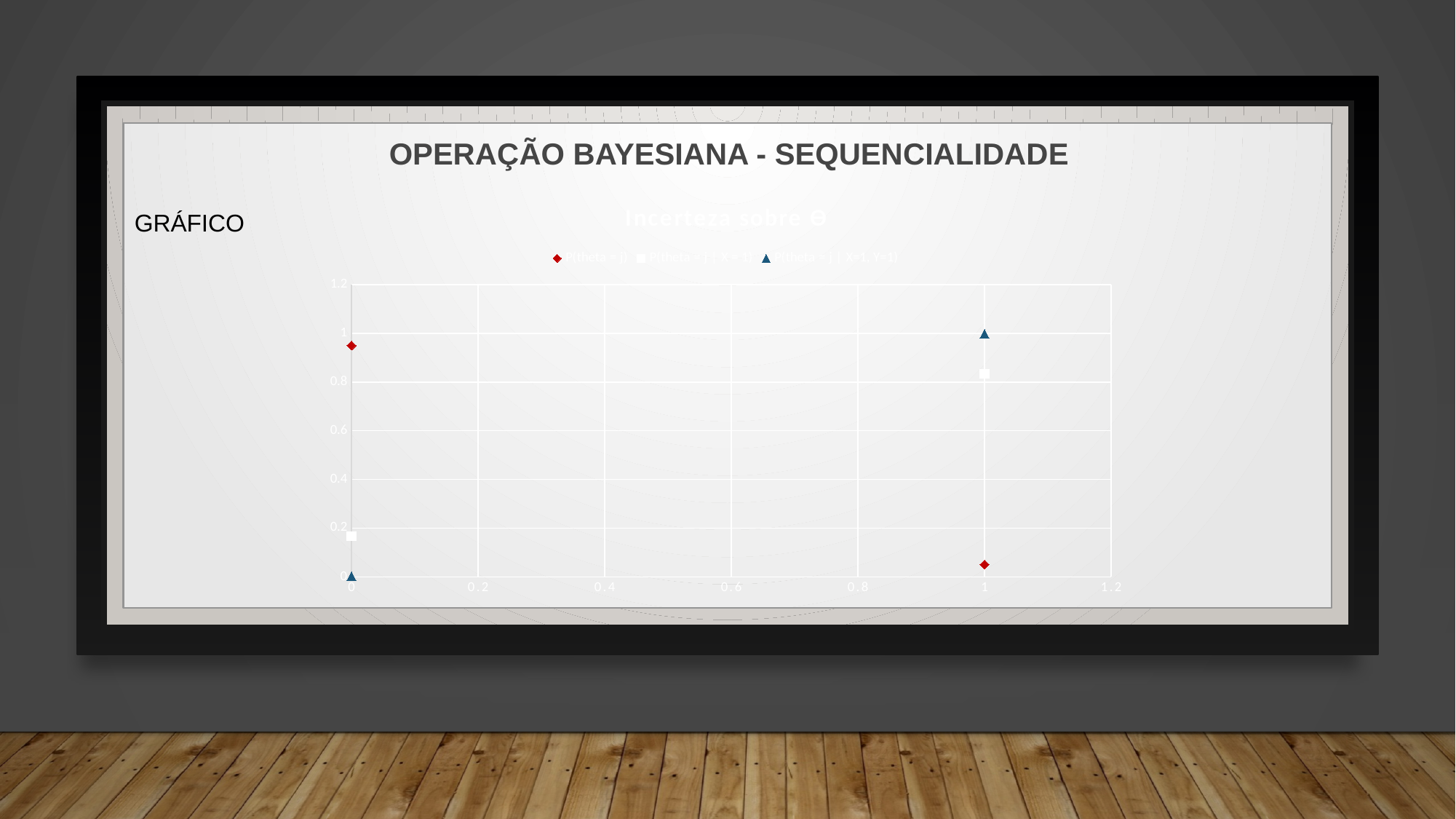
What is the highest value shown on the y axis of the chart? 1.2 At x = 1, which series has the lower y value: the red diamond series or the blue triangle series? the red diamond series What kind of chart is shown on the slide? scatter chart Is the y value of the white square series at x = 1 greater or less than 0.6? greater What is the title of the chart? Incerteza sobre Θ Is the y value of the red diamond series at x = 0 greater or less than 0.8? greater At x = 0, which series has the higher y value: the red diamond series or the white square series? the red diamond series How many series does the legend of the chart list? 3 How many data points are plotted in the chart in total? 6 Is the y value of the red diamond series at x = 1 greater or less than 0.2? less